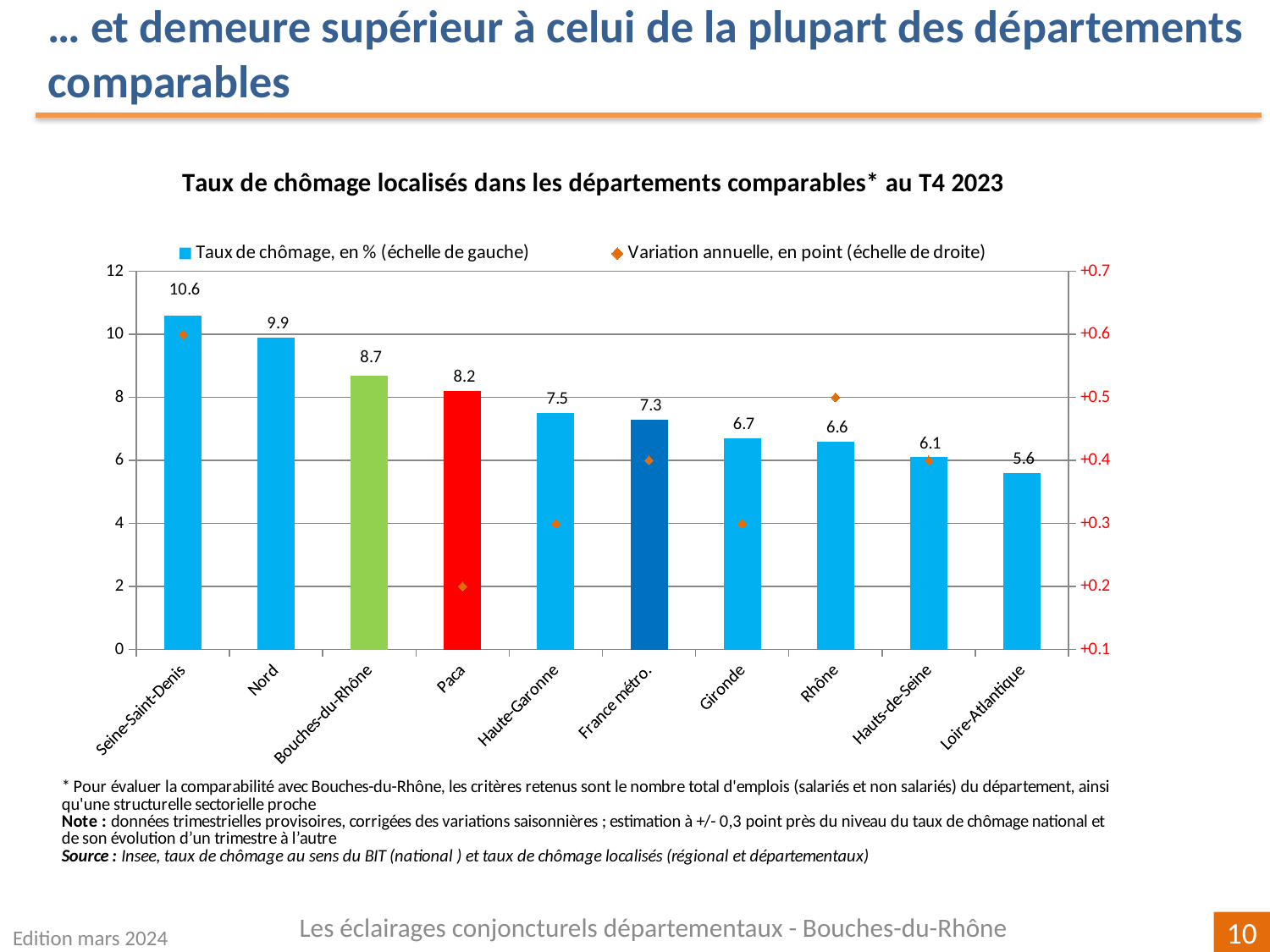
Which has a higher unemployment rate, Gironde or Rhône? Gironde What is the annual variation (variation annuelle) in points for Rhône, read on the right-hand scale? +0.5 How many series does the legend list? 2 Do the unemployment rates rise or fall from left to right along the x axis? fall What is the annual variation in points for Paca, read on the right-hand scale? +0.2 What is the unemployment rate shown for Bouches-du-Rhône? 8.7 What is the difference between the unemployment rates of Bouches-du-Rhône and Paca? 0.5 Which département has the lowest unemployment rate on the chart? Loire-Atlantique How many départements/areas are shown on the x axis? 10 Which département has the highest unemployment rate on the chart? Seine-Saint-Denis What is the unemployment rate (taux de chômage) for Seine-Saint-Denis? 10.6 What is the unemployment rate shown for France métro.? 7.3